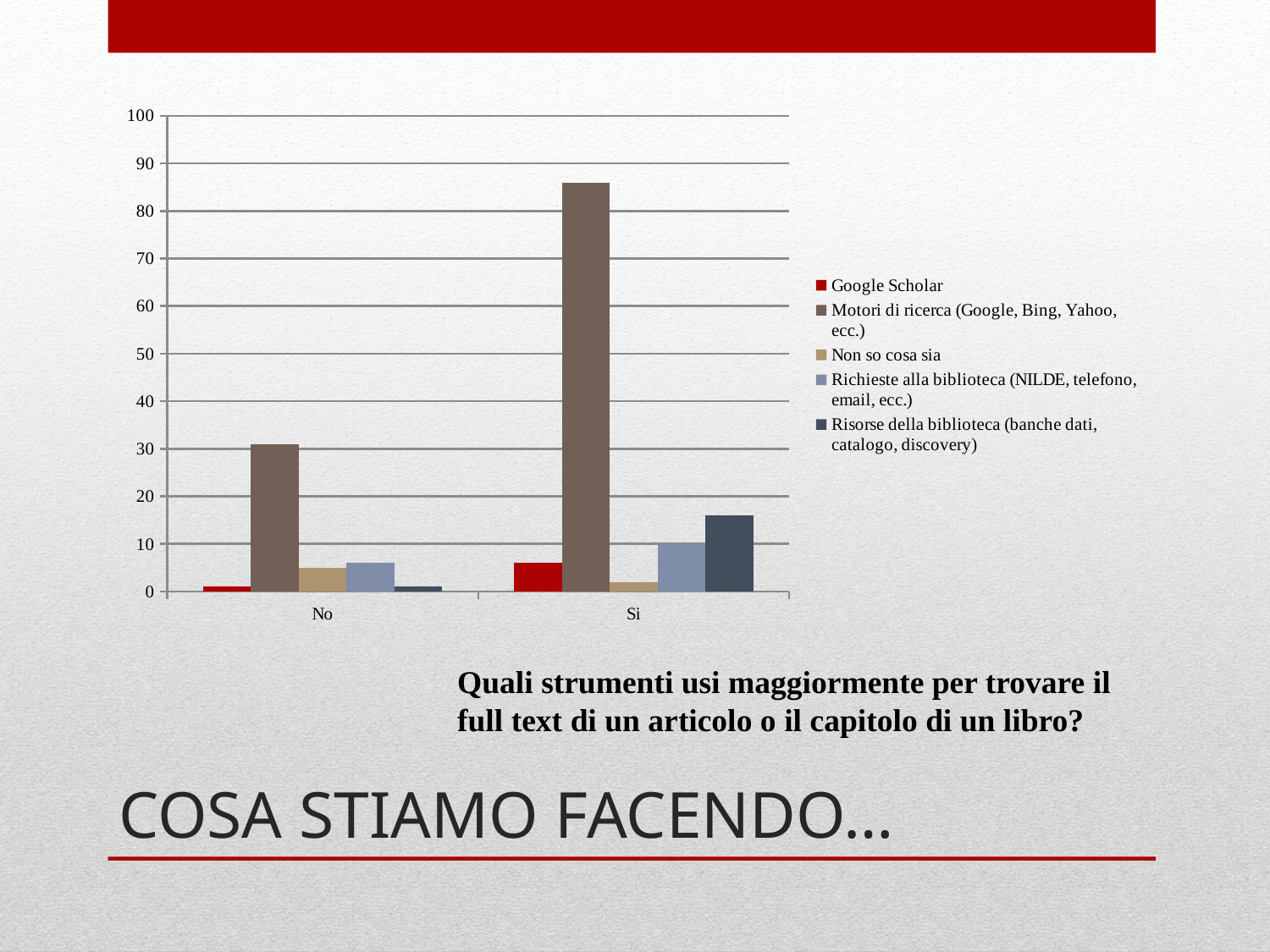
Is the value for 'Google Scholar' in the 'Si' category greater or less than 10? less Is the value for 'Motori di ricerca' in the 'Si' category greater or less than 80? greater Which is larger: 'Motori di ricerca' for 'Si' or 'Motori di ricerca' for 'No'? Motori di ricerca for Si What kind of chart is shown on the slide? bar chart How many categories are shown on the x axis? 2 How many series does the legend list? 5 Is the value for 'Motori di ricerca' in the 'No' category greater or less than 40? less Which series has the highest value in the 'No' category? Motori di ricerca (Google, Bing, Yahoo, ecc.) Which series has the highest value in the 'Si' category? Motori di ricerca (Google, Bing, Yahoo, ecc.) What colour represents 'Google Scholar' in the legend? red Which is larger in the 'Si' category: 'Risorse della biblioteca' or 'Non so cosa sia'? Risorse della biblioteca